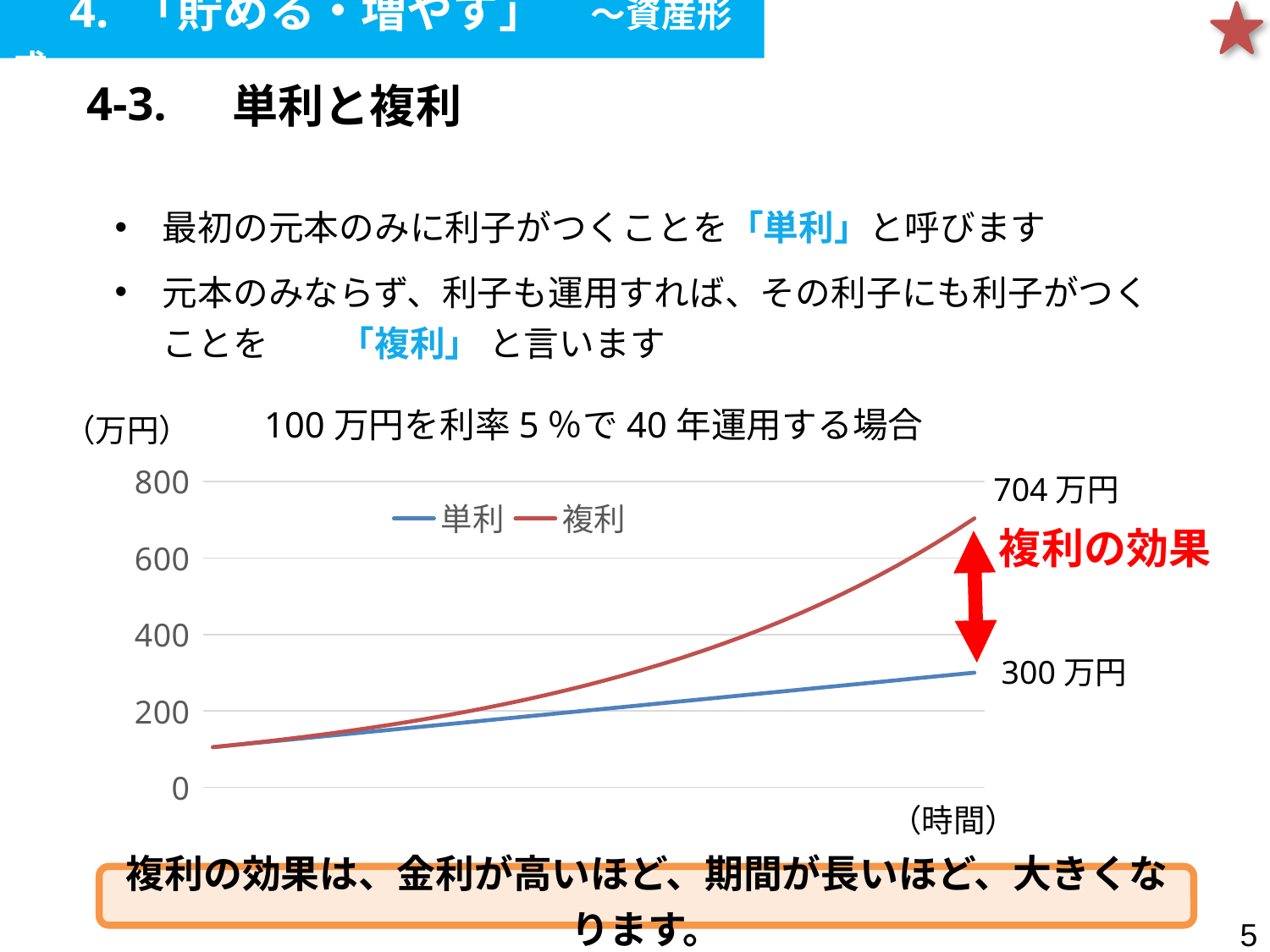
What is the difference between the final values of the 複利 and 単利 lines? 404万円 Do the values of the 複利 line rise or fall along the x axis? rise What is the title of the chart? 100万円を利率5％で40年運用する場合 Is the final value of the 複利 line greater or less than 600? greater Is the final value of the 単利 line greater or less than 400? less How many series does the chart legend list? 2 What is the highest tick value shown on the chart's vertical axis? 800 What type of chart is shown on the slide? line chart What is the final value of the 単利 (simple interest) line after 40 years? 300万円 Which series ends at a higher value, 単利 or 複利? 複利 What are the two series named in the chart legend? 単利 and 複利 What is the final value of the 複利 (compound interest) line after 40 years? 704万円